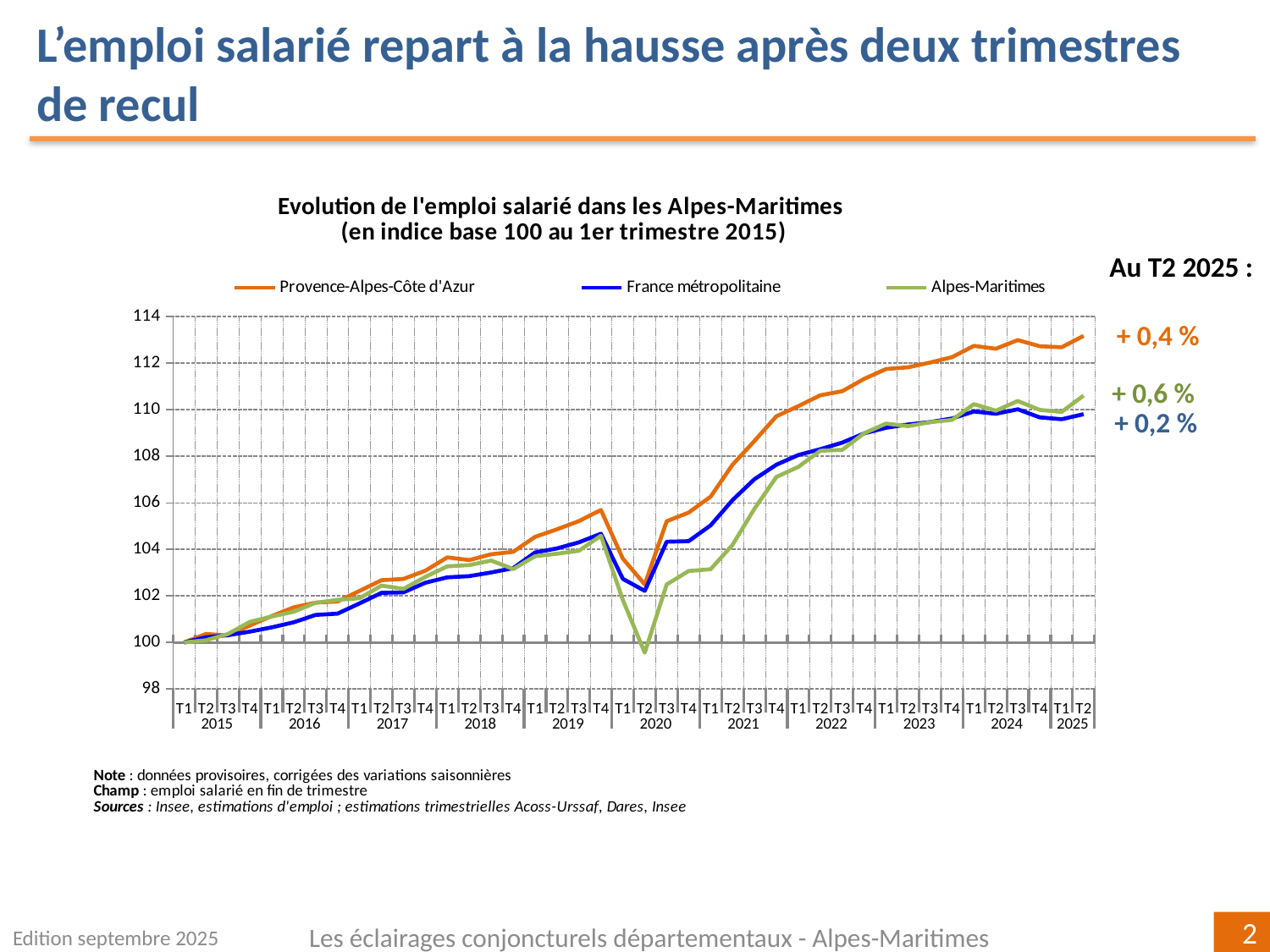
Is the value for Alpes-Maritimes at T2 2020 greater or less than 100? less What is the title of the chart? Evolution de l'emploi salarié dans les Alpes-Maritimes (en indice base 100 au 1er trimestre 2015) How many series does the legend list? 3 At T2 2025, which is higher: Alpes-Maritimes or France métropolitaine? Alpes-Maritimes Which series has the lowest value at T2 2020? Alpes-Maritimes Overall, do the series rise or fall from T1 2015 to T2 2025? rise What quarterly change is annotated for Alpes-Maritimes at T2 2025? + 0,6 % Which colour is used for the Alpes-Maritimes series? green What kind of chart is shown on the slide? line chart Which series has the highest value at T2 2025? Provence-Alpes-Côte d'Azur Is the value for Provence-Alpes-Côte d'Azur at T2 2025 greater or less than 112? greater